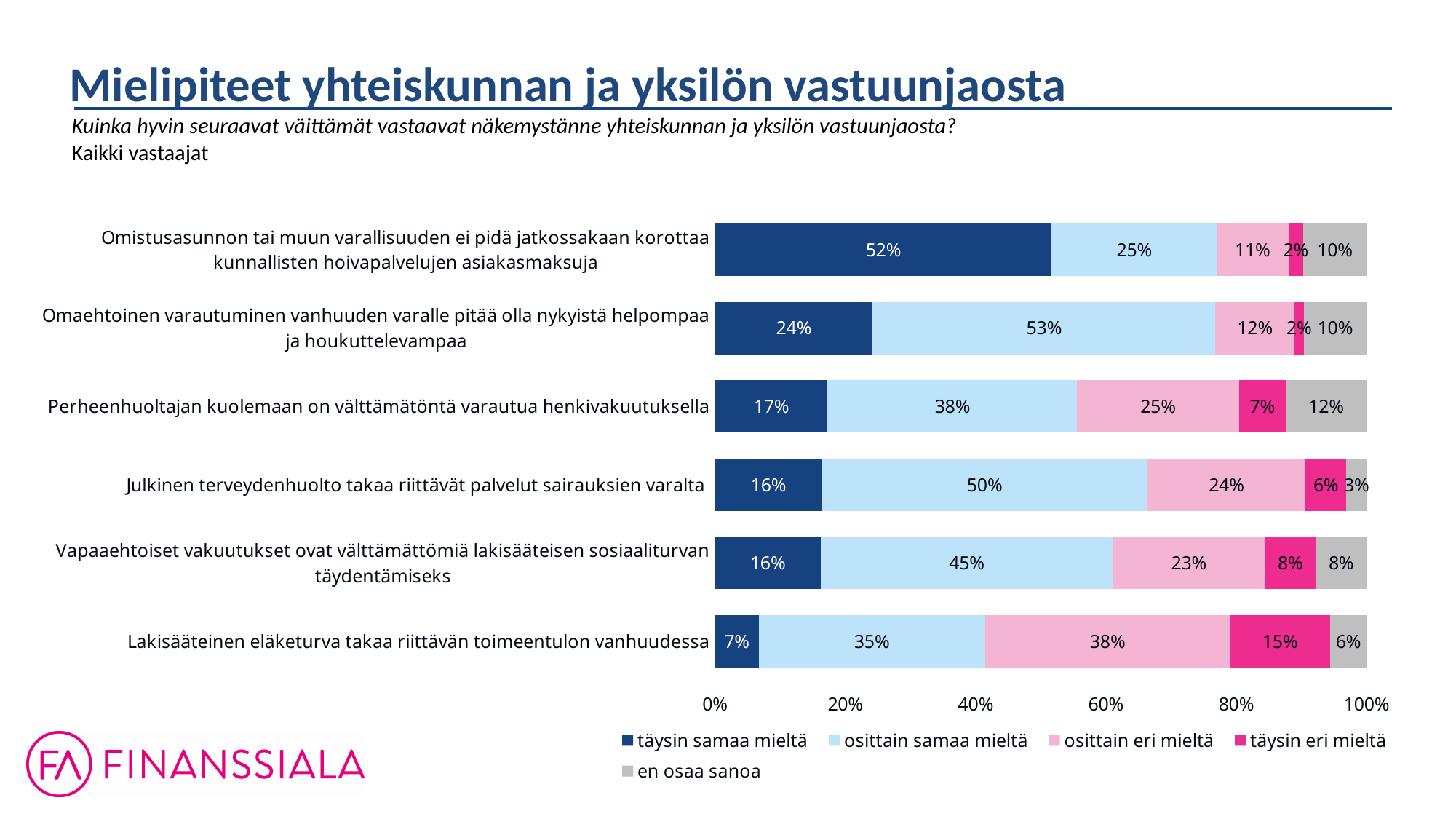
What colour represents the 'täysin samaa mieltä' series in the chart? Dark blue What is the difference between the 'osittain eri mieltä' values for 'Lakisääteinen eläketurva takaa riittävän toimeentulon vanhuudessa' and 'Omistusasunnon tai muun varallisuuden ei pidä jatkossakaan korottaa kunnallisten hoivapalvelujen asiakasmaksuja'? 27 percentage points What is the 'osittain samaa mieltä' value for 'Omaehtoinen varautuminen vanhuuden varalle pitää olla nykyistä helpompaa ja houkuttelevampaa'? 53% What is the 'en osaa sanoa' value for 'Julkinen terveydenhuolto takaa riittävät palvelut sairauksien varalta'? 3% What kind of chart is shown on the slide? Stacked bar chart Which statement has the lowest 'täysin samaa mieltä' share? Lakisääteinen eläketurva takaa riittävän toimeentulon vanhuudessa What is the 'täysin samaa mieltä' value for 'Omistusasunnon tai muun varallisuuden ei pidä jatkossakaan korottaa kunnallisten hoivapalvelujen asiakasmaksuja'? 52% Which statement has the highest 'täysin samaa mieltä' share? Omistusasunnon tai muun varallisuuden ei pidä jatkossakaan korottaa kunnallisten hoivapalvelujen asiakasmaksuja How many statements (categories) are plotted in the chart? 6 Which is larger: the 'täysin eri mieltä' value for 'Vapaaehtoiset vakuutukset ovat välttämättömiä lakisääteisen sosiaaliturvan täydentämiseks' or for 'Perheenhuoltajan kuolemaan on välttämätöntä varautua henkivakuutuksella'? Vapaaehtoiset vakuutukset ovat välttämättömiä lakisääteisen sosiaaliturvan täydentämiseks What is the 'täysin eri mieltä' value for 'Lakisääteinen eläketurva takaa riittävän toimeentulon vanhuudessa'? 15% How many series does the legend list? 5